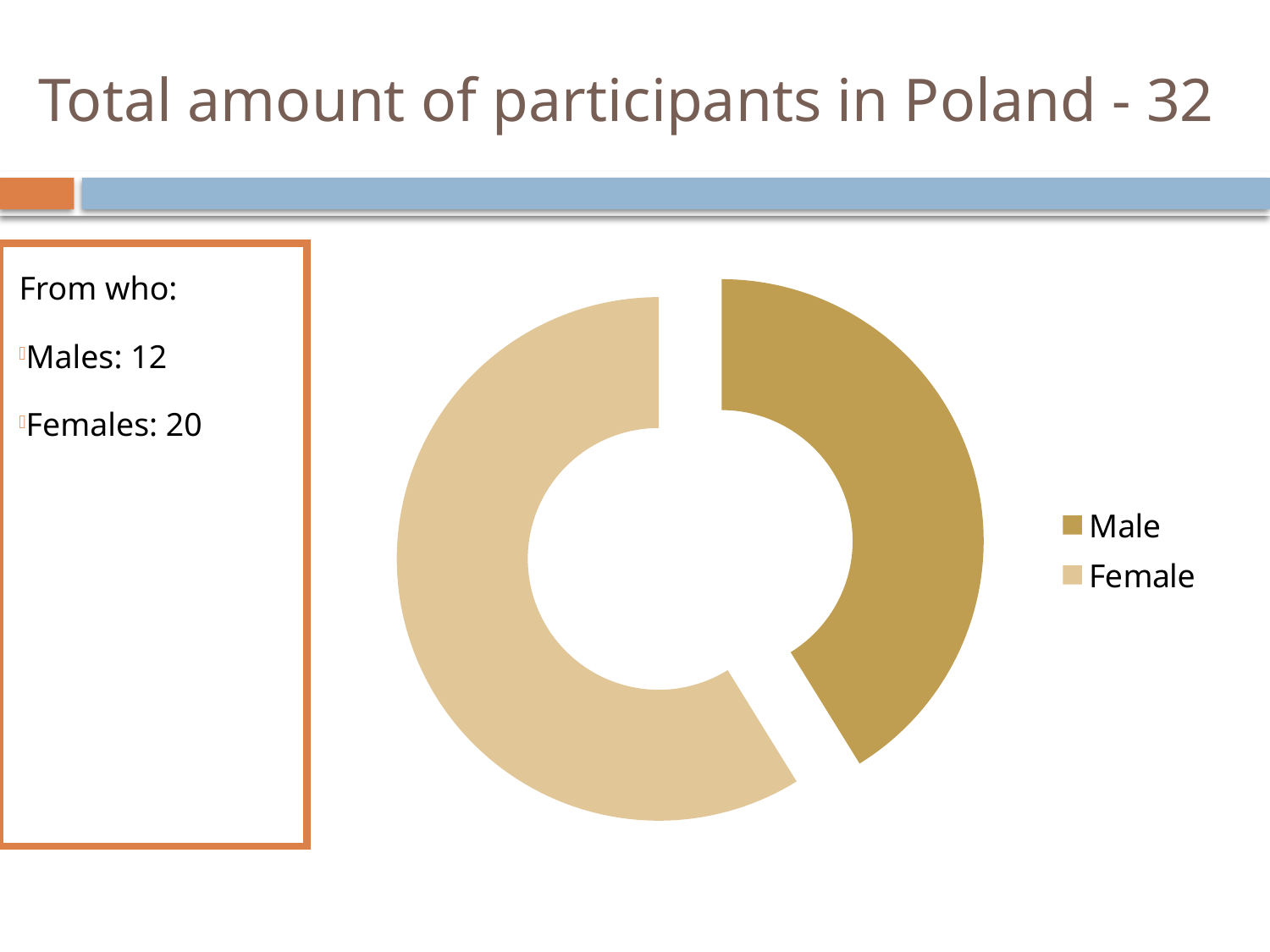
According to the slide, how many male participants are there? 12 Which category has the smallest share of the chart? Male What kind of chart is shown on the slide? doughnut chart How many more female participants than male participants are there? 8 Which category has the larger slice in the chart, Male or Female? Female According to the slide, how many female participants are there? 20 Which category has the largest share of the chart? Female How many categories does the chart show? 2 How many entries does the chart legend list? 2 What is the title of the slide containing the chart? Total amount of participants in Poland - 32